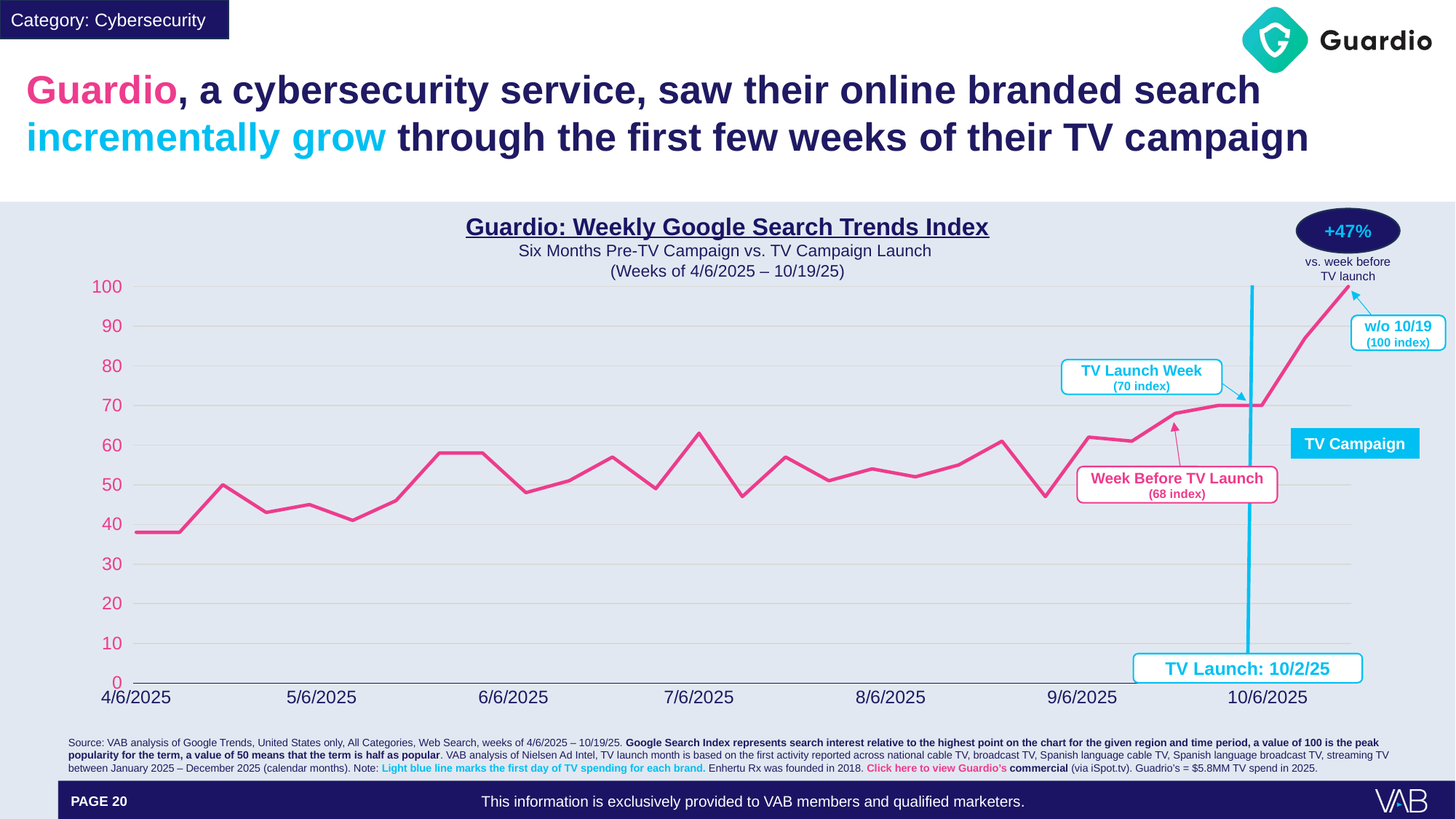
What kind of chart is shown on the slide? line chart What TV launch date is marked on the chart? 10/2/25 What is the index value for the Week Before TV Launch? 68 What percentage change vs. the week before TV launch is called out on the slide? +47% What is the index value for the week of 10/19? 100 By how much does the index for the week of 10/19 exceed the TV Launch Week index? 30 What is the difference between the TV Launch Week index and the Week Before TV Launch index? 2 Which is larger, the index for the TV Launch Week or the index for the Week Before TV Launch? TV Launch Week What is the Google Search Trends Index value for the TV Launch Week? 70 Is the index value at 4/6/2025 greater or less than 50? less Which week has the highest index value on the chart? w/o 10/19 Does the index rise or fall between the TV Launch Week and the week of 10/19? rise